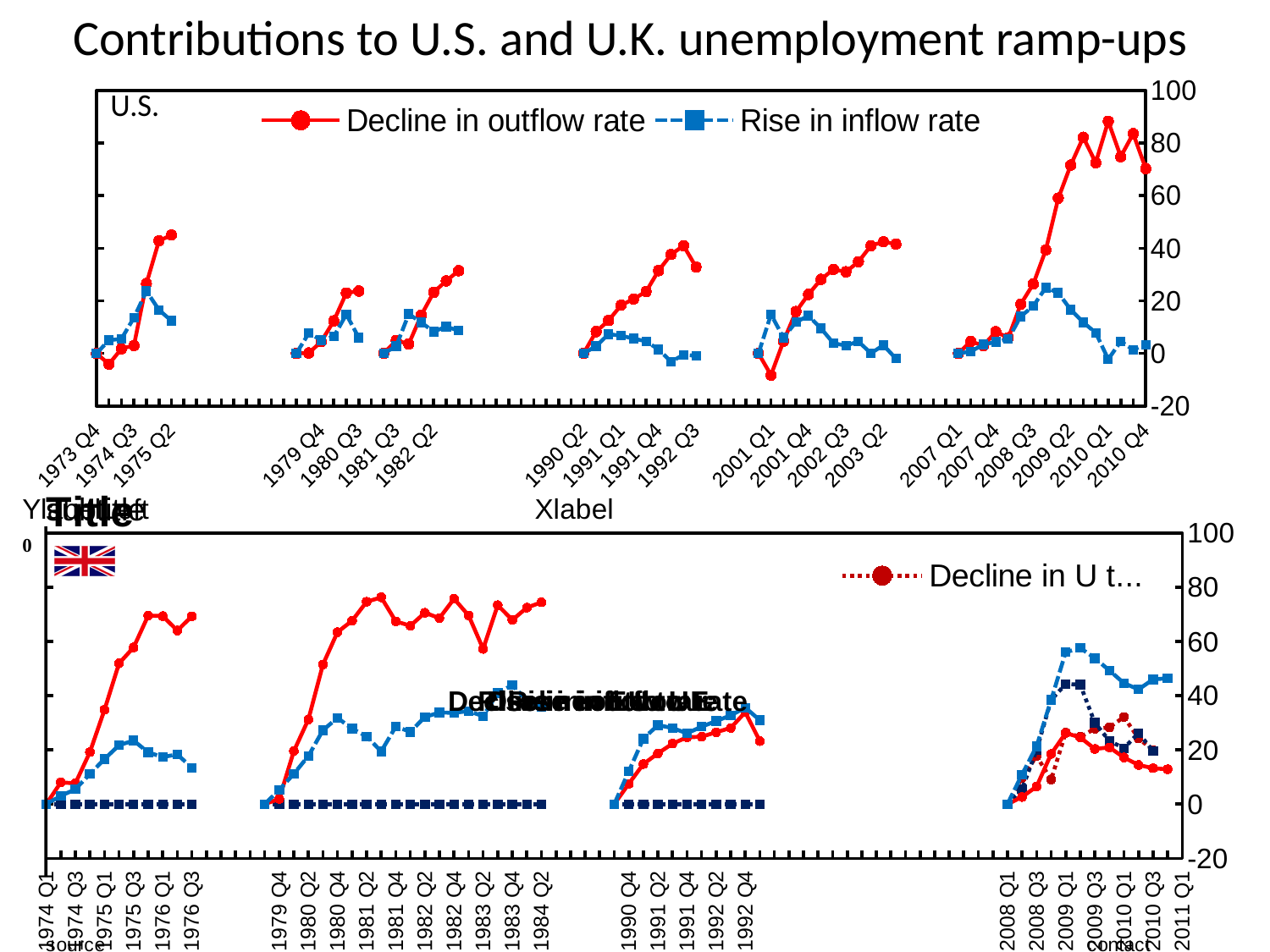
In the top (U.S.) chart, which series is higher at 2010 Q1, Decline in outflow rate or Rise in inflow rate? Decline in outflow rate In the bottom (U.K.) chart, is the value of the solid red line at 1981 Q2 greater or less than 60? greater In the top (U.S.) chart, how many series does the legend list? 2 In the top (U.S.) chart, does the Decline in outflow rate rise or fall from 2007 Q1 to 2010 Q1? Rise In the top (U.S.) chart, in which year does the Decline in outflow rate reach its highest value? 2010 In the top (U.S.) chart, what kind of chart is shown? Line chart In the top (U.S.) chart, is the value of Rise in inflow rate at 2009 Q2 greater or less than 40? less In the top (U.S.) chart, what colour is the Rise in inflow rate line? Blue What is the title of the slide's charts? Contributions to U.S. and U.K. unemployment ramp-ups In the bottom (U.K.) chart, which line is higher at 2009 Q1, the solid red line or the dashed blue line? The dashed blue line In the top (U.S.) chart, is the value of Decline in outflow rate at 2010 Q1 greater or less than 80? greater In the top (U.S.) chart, how many separate episodes (line segments) are plotted? 6